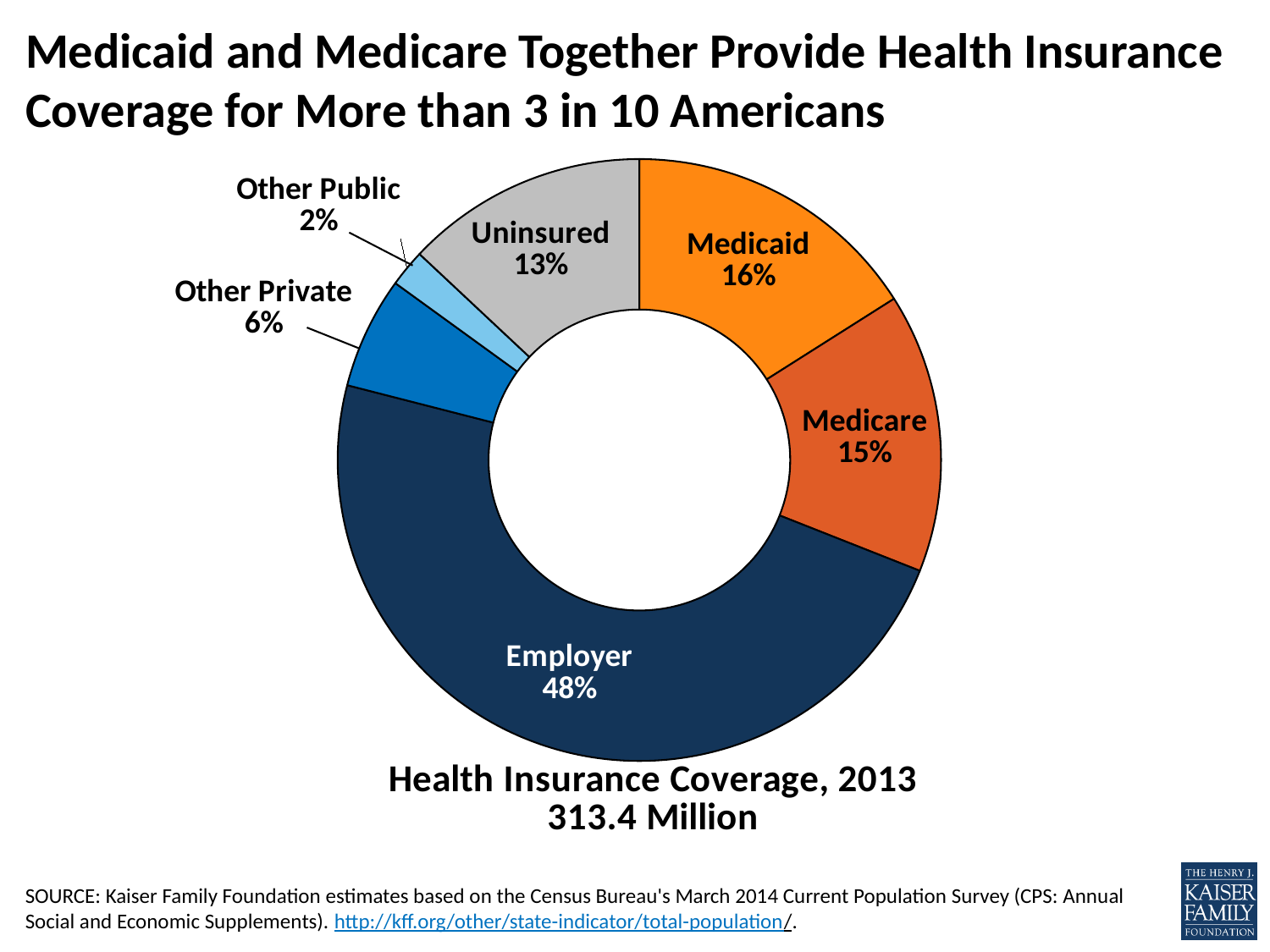
What share of health insurance coverage is Medicare? 15% How many categories are shown in the chart? 6 What is the difference in percentage points between Employer and Medicaid? 32 Which is larger, the Other Private share or the Uninsured share? Uninsured What share of the population is Uninsured? 13% What total population does the chart represent, according to the label below it? 313.4 Million What kind of chart is shown on the slide? Pie chart (donut) What share of health insurance coverage is Other Public? 2% Which category has the smallest share of the pie? Other Public Which category has the largest share of the pie? Employer What share of health insurance coverage is Medicaid? 16% What share of health insurance coverage is Employer? 48%